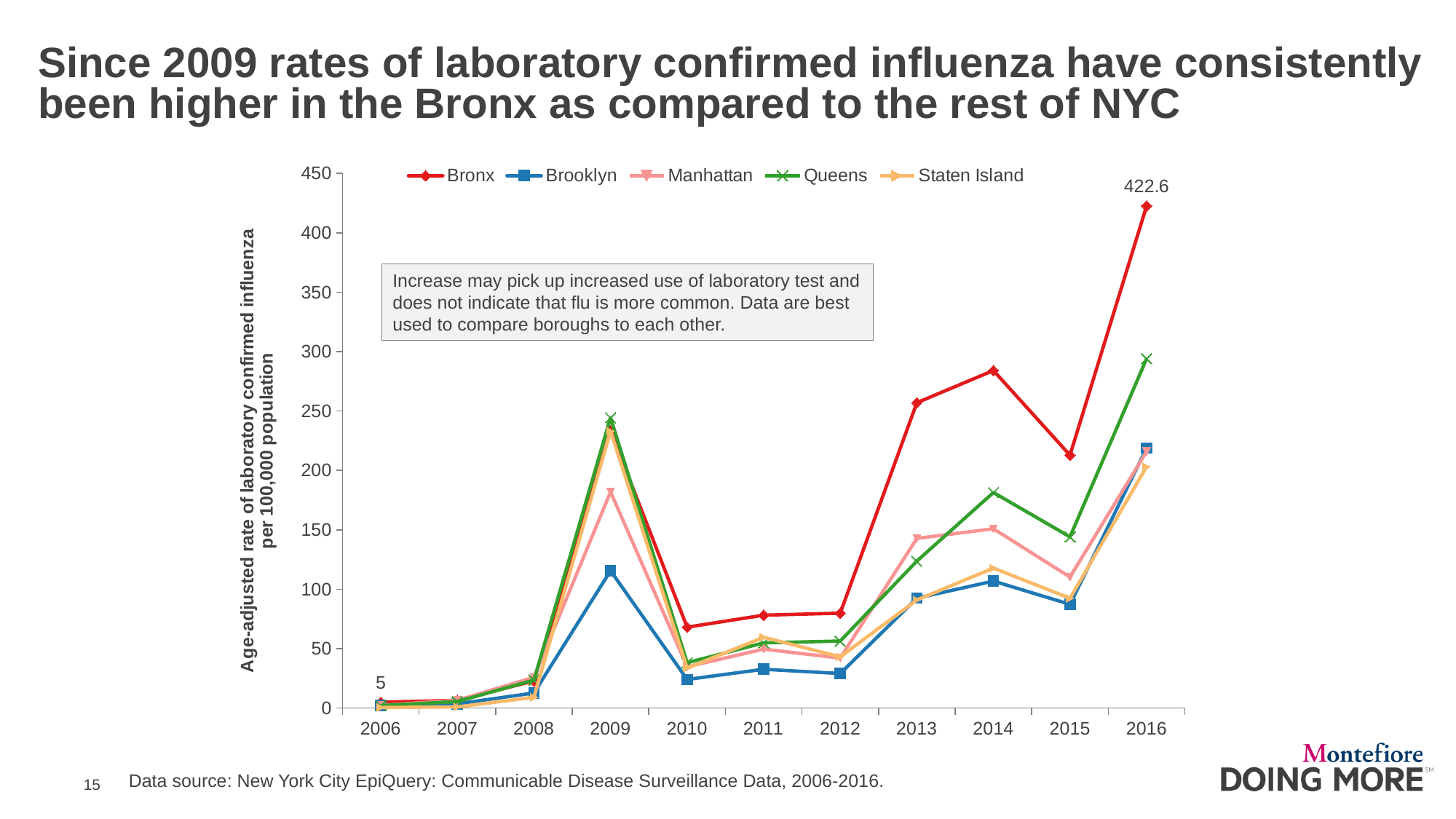
How many series does the legend list? 5 Does the Bronx rate rise or fall from 2014 to 2015? fall Which borough has the highest rate in 2016? Bronx In 2016, which is larger: the rate for the Bronx or the rate for Queens? Bronx What is the age-adjusted rate for the Bronx in 2006? 5 Which borough has the lowest rate in 2009? Brooklyn Is the value for Brooklyn in 2009 greater or less than 150? less Is the value for Queens in 2016 greater or less than 250? greater What kind of chart is shown on the slide? line chart By how much did the Bronx rate increase from 2006 to 2016? 417.6 How many years are shown on the x axis? 11 What is the age-adjusted rate for the Bronx in 2016? 422.6